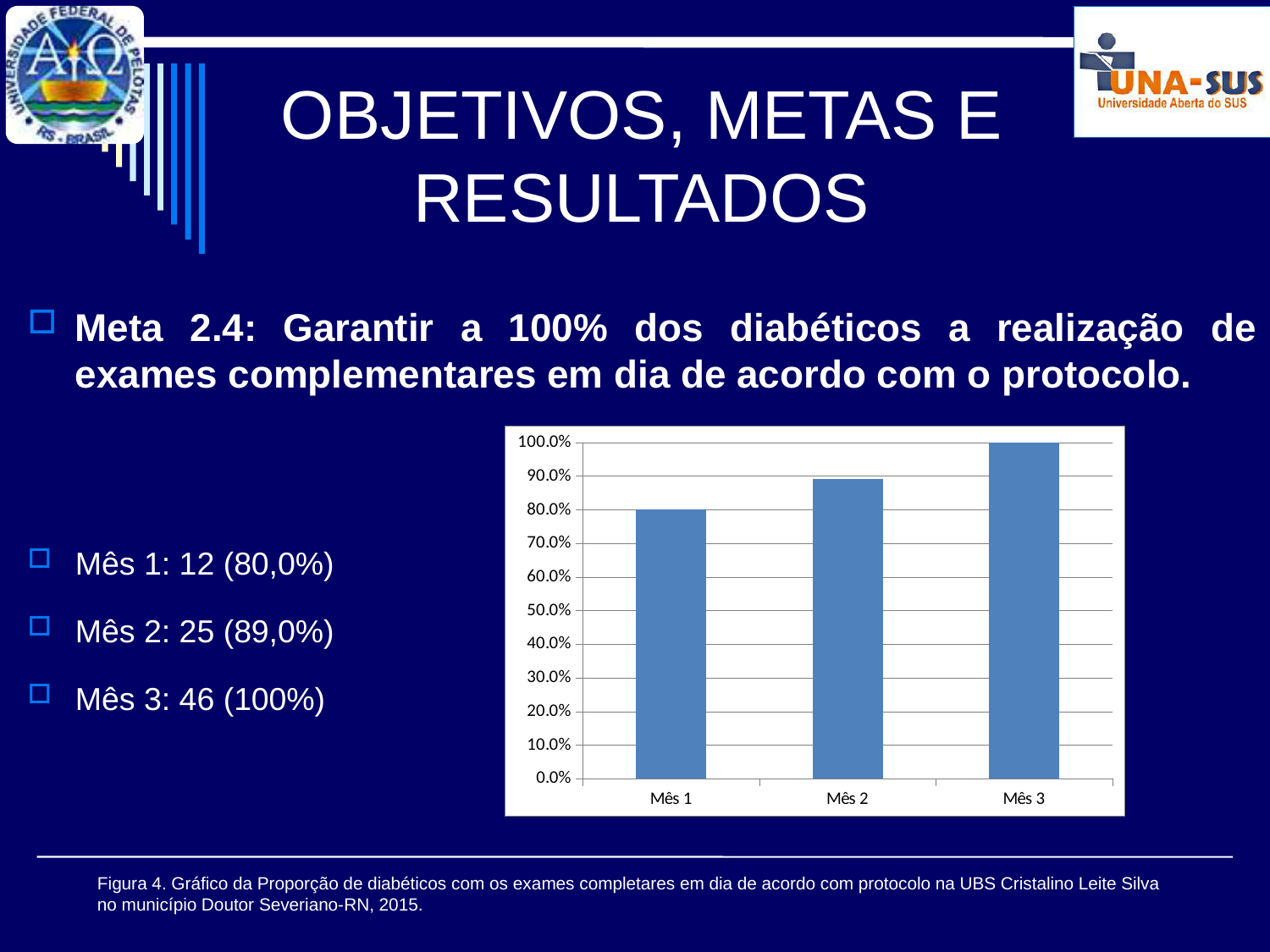
What is the value for Mês 1 in the chart? 80.0% Is the value for Mês 2 greater or less than 80.0%? greater Which is larger, the value for Mês 2 or the value for Mês 1? Mês 2 What is the highest value shown on the y axis of the chart? 100.0% What is the difference between the values for Mês 3 and Mês 1? 20.0% What is the value for Mês 3 in the chart? 100.0% How many categories are shown on the x axis of the chart? 3 Is the value for Mês 2 greater or less than 90.0%? less Do the values rise or fall from Mês 1 to Mês 3? rise Which month has the lowest value in the chart? Mês 1 Which month has the highest value in the chart? Mês 3 What kind of chart is shown on the slide? bar chart